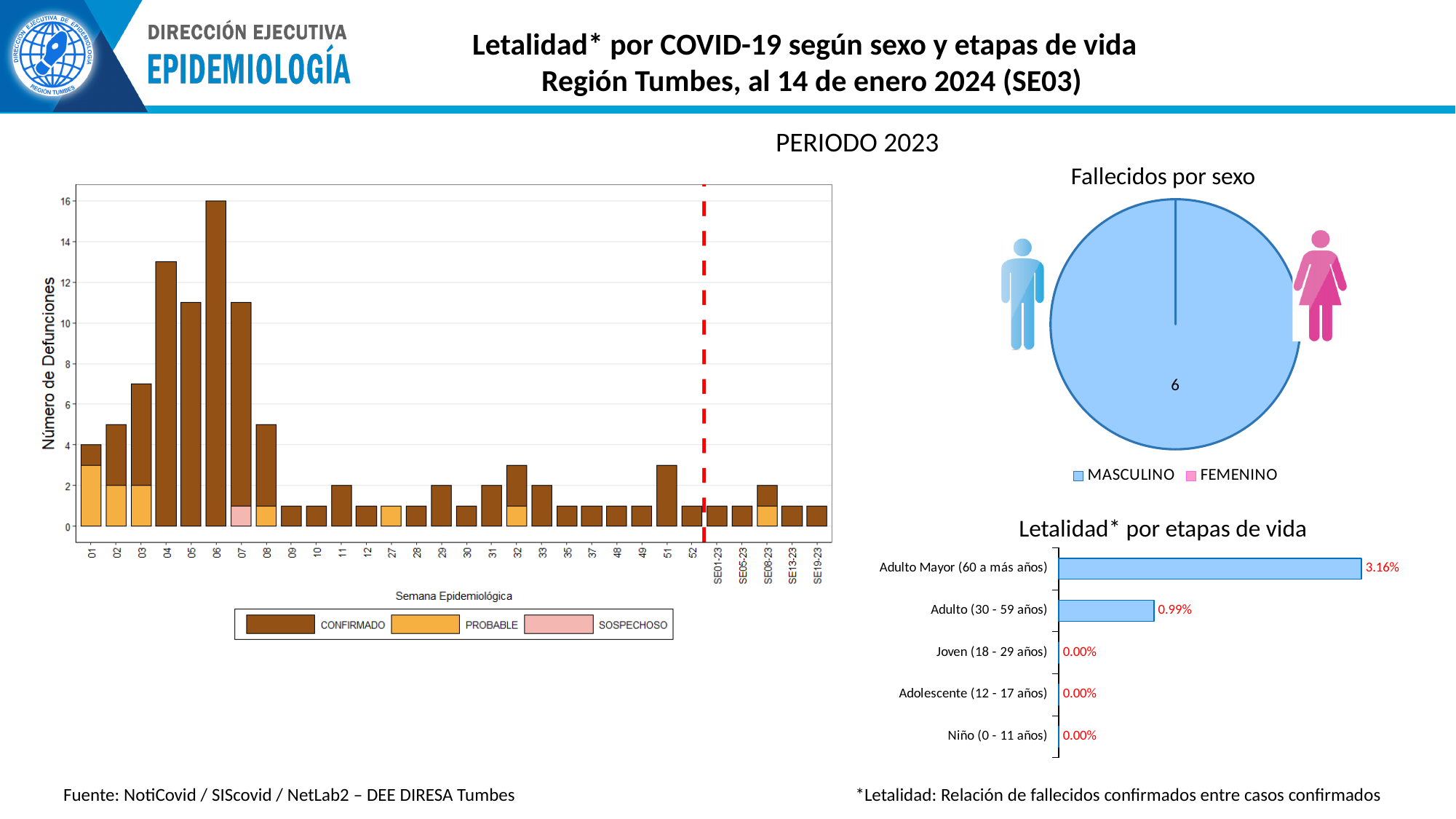
In the 'Fallecidos por sexo' pie chart, what is the value shown for MASCULINO? 6 In the 'Letalidad* por etapas de vida' chart, what is the difference between the values for Adulto Mayor (60 a más años) and Adulto (30 - 59 años)? 2.17% How many series does the legend of the 'Fallecidos por sexo' pie chart list? 2 In the 'Letalidad* por etapas de vida' chart, what is the value for Joven (18 - 29 años)? 0.00% In the weekly 'Número de Defunciones' bar chart on the left, what is the total height of the bar for week 06? 16 In the 'Letalidad* por etapas de vida' chart, what is the value for Adulto Mayor (60 a más años)? 3.16% In the 'Letalidad* por etapas de vida' chart, what is the value for Adulto (30 - 59 años)? 0.99% What kind of chart is 'Letalidad* por etapas de vida'? Bar chart In the 'Letalidad* por etapas de vida' chart, which age group has the highest value? Adulto Mayor (60 a más años) In the weekly 'Número de Defunciones' bar chart on the left, is the value for week 04 greater or less than 12? greater In the 'Letalidad* por etapas de vida' chart, how many age groups are shown? 5 In the weekly 'Número de Defunciones' bar chart on the left, which epidemiological week has the highest bar? 06